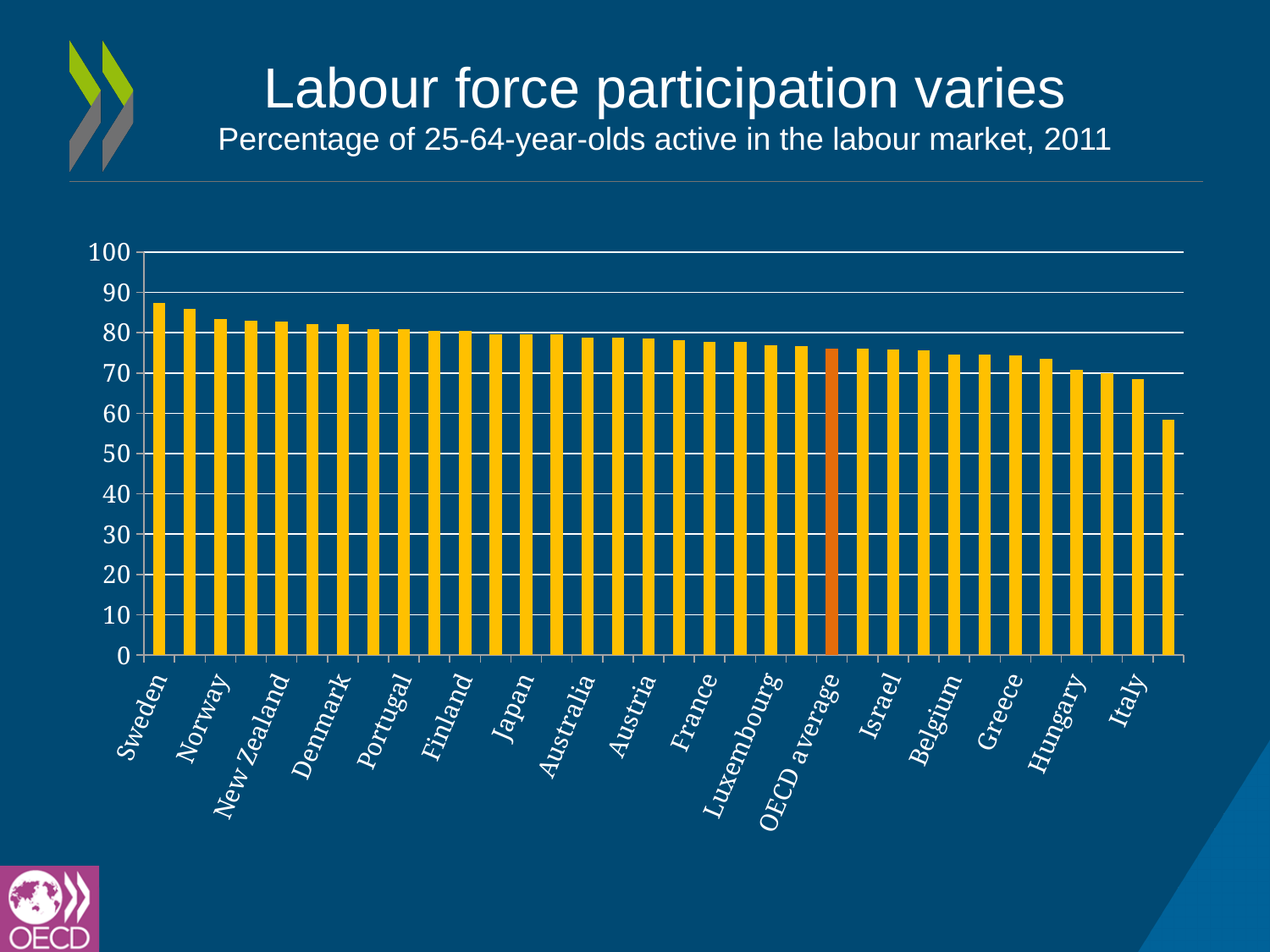
Is the value for Italy greater or less than 60? greater Is the value for Greece greater or less than 70? greater Which has a higher labour force participation rate, Norway or Greece? Norway Is the value for Norway greater or less than 80? greater What kind of chart is shown on the slide? bar chart Which bar is shown in a different colour (orange) from the rest? OECD average Which labelled country has the highest labour force participation rate? Sweden Which labelled country has the lowest labour force participation rate? Italy Do the values rise or fall moving from left to right along the x axis? fall Which has a lower labour force participation rate, Denmark or Hungary? Hungary